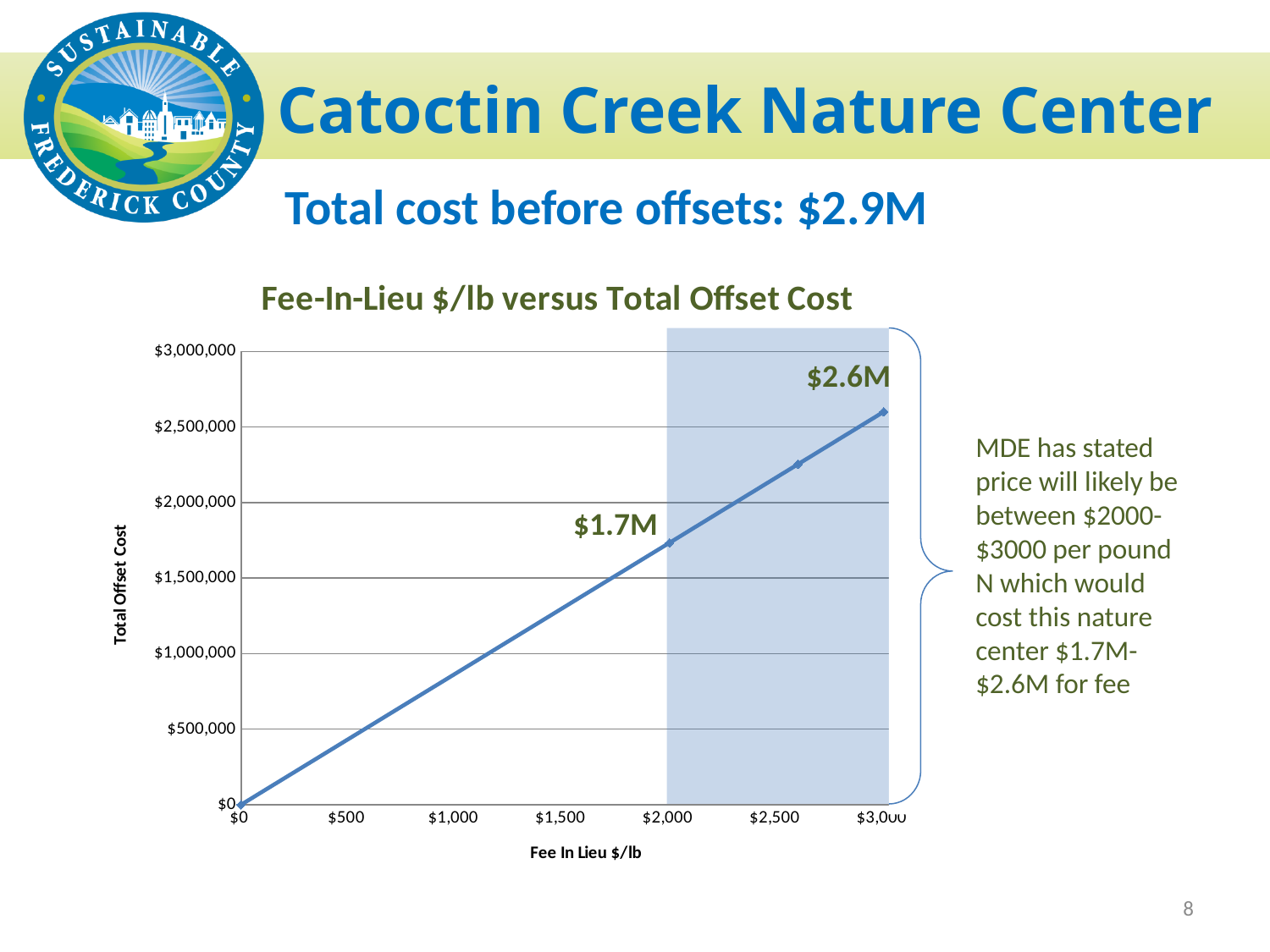
What total offset cost is labelled on the chart at a fee in lieu of $2,000 per pound? $1.7M Is the total offset cost at a fee in lieu of $1,500/lb greater or less than $1,500,000? less Is the total offset cost at a fee in lieu of $2,500/lb greater or less than $2,000,000? greater How many data point markers are plotted on the line? 4 What is the difference between the labelled total offset cost at $3,000/lb and at $2,000/lb? $0.9M At which fee in lieu value on the x axis is the total offset cost highest? $3,000 Which fee in lieu gives the larger total offset cost, $2,000/lb or $3,000/lb? $3,000/lb What is the label of the x axis of the chart? Fee In Lieu $/lb What kind of chart is shown on the slide? line chart Does the total offset cost rise or fall as the fee in lieu increases along the x axis? rises What total offset cost is labelled on the chart at a fee in lieu of $3,000 per pound? $2.6M What is the title of the chart? Fee-In-Lieu $/lb versus Total Offset Cost